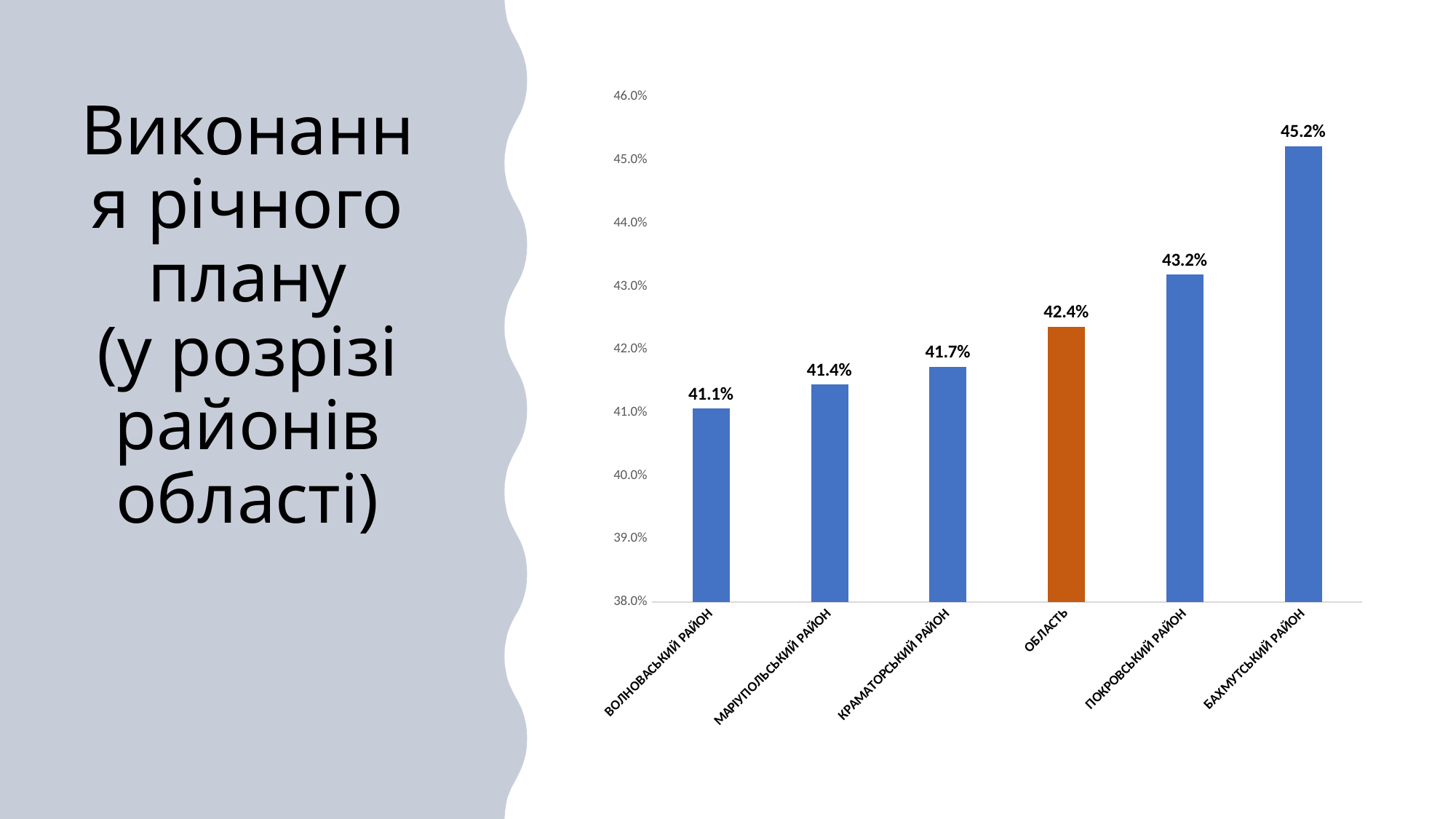
Is the value for МАРІУПОЛЬСЬКИЙ РАЙОН greater or less than 42.0%? less What is the difference between the values for БАХМУТСЬКИЙ РАЙОН and ВОЛНОВАСЬКИЙ РАЙОН? 4.1% What is the value for ОБЛАСТЬ? 42.4% Which category has the highest value? БАХМУТСЬКИЙ РАЙОН Which bar is coloured orange instead of blue? ОБЛАСТЬ What is the value for ВОЛНОВАСЬКИЙ РАЙОН? 41.1% How many categories are shown on the chart? 6 Which category has the lowest value? ВОЛНОВАСЬКИЙ РАЙОН Do the values rise or fall from left to right along the x axis? rise What kind of chart is shown on the slide? bar chart What is the value for ПОКРОВСЬКИЙ РАЙОН? 43.2% Which is larger, the value for КРАМАТОРСЬКИЙ РАЙОН or the value for ПОКРОВСЬКИЙ РАЙОН? ПОКРОВСЬКИЙ РАЙОН